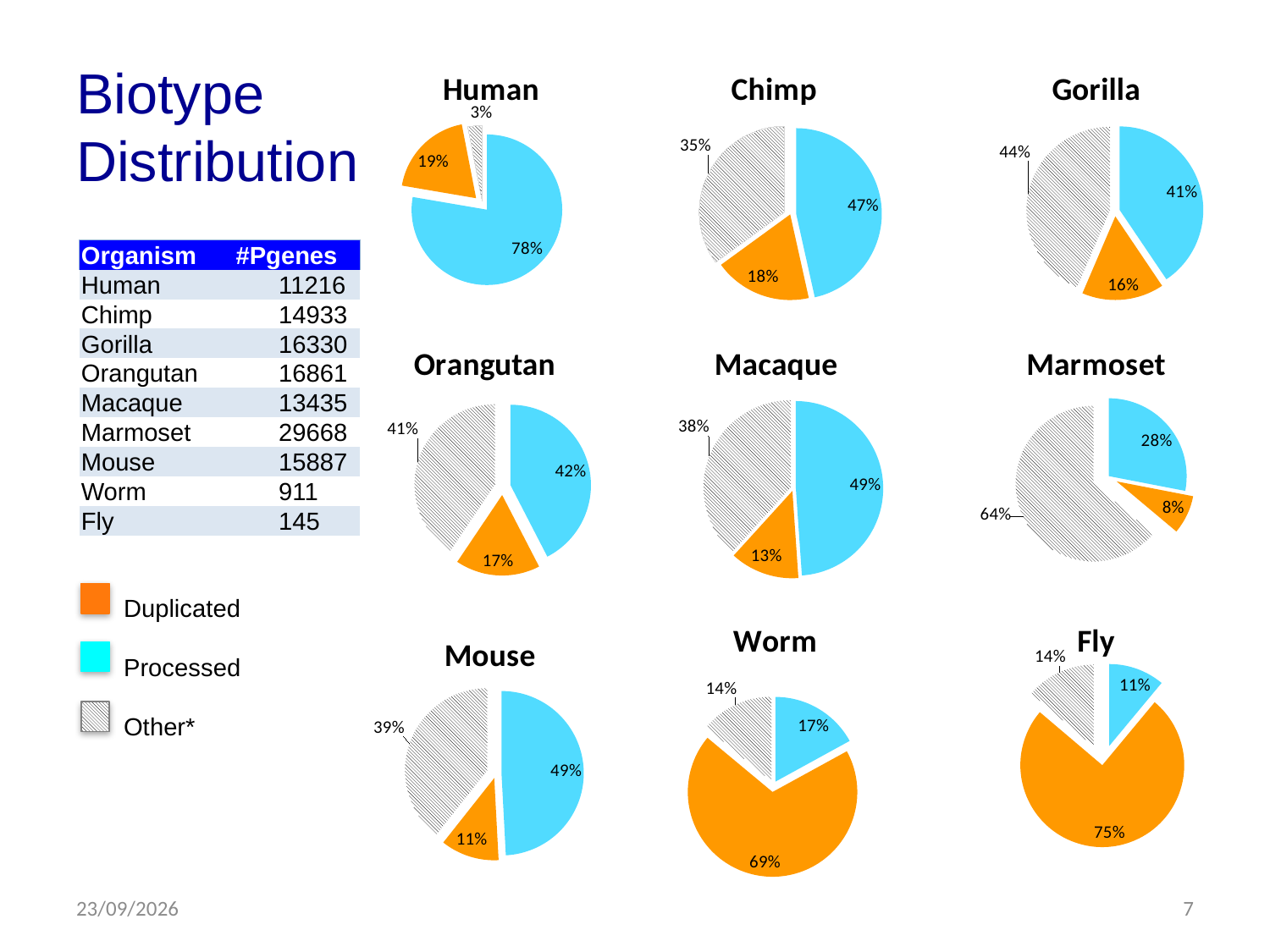
How many pie charts are shown on the slide? 9 In the Gorilla pie chart, which biotype has the largest slice? Other* In the Fly pie chart, what is the difference between the Duplicated share and the Processed share? 64% Which colour represents the Processed biotype in the legend? Cyan What type of chart is used for the Mouse biotype distribution? Pie chart In the Orangutan pie chart, what is the combined share of the Processed and Duplicated slices? 59% How many biotype categories does the legend list? 3 In the Chimp pie chart, what percentage is shown for the Duplicated slice? 18% In the Marmoset pie chart, which biotype has the smallest slice? Duplicated In the Human pie chart, what share is labelled for the Processed slice? 78% In the Worm pie chart, which is larger, the Duplicated slice or the Processed slice? Duplicated In the Macaque pie chart, what percentage is labelled for the Other* slice? 38%